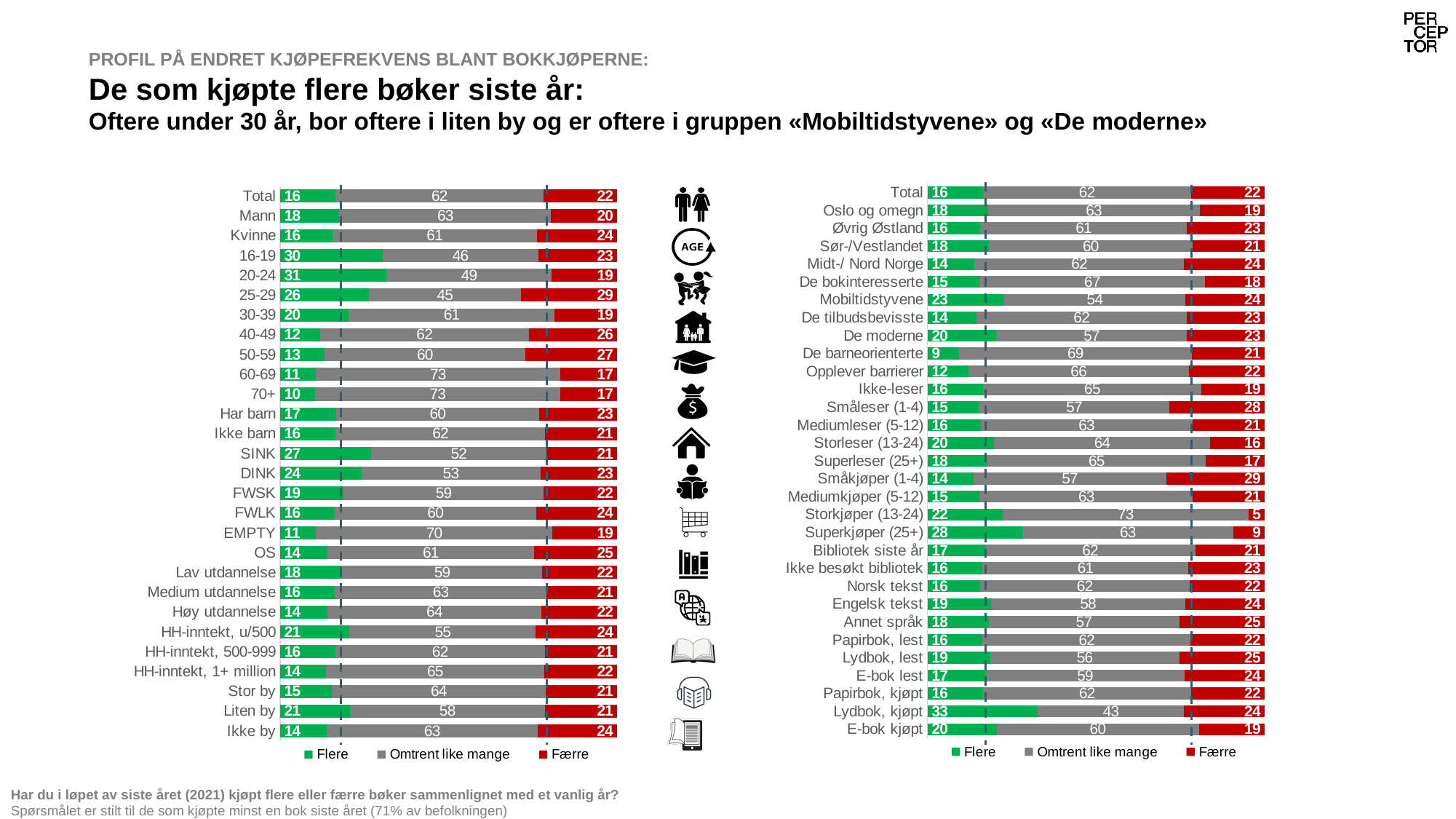
In the left chart, what is the 'Flere' value for the 20-24 age group? 31 In the left chart, which category has the lowest 'Flere' value? 70+ In the right chart, which category has the lowest 'Færre' value? Storkjøper (13-24) What kind of chart is the left chart on the slide? Stacked bar chart In the right chart, which category has the highest 'Flere' value? Lydbok, kjøpt In the right chart, what is the total of the stacked bar for Lydbok, kjøpt? 100 How many series does the legend of the left chart list? 3 In the left chart, what is the difference between the 'Færre' values for 25-29 and 20-24? 10 How many categories are plotted in the right chart? 31 Which colour represents 'Færre' in the charts? Red In the right chart, which has a larger 'Flere' value: De moderne or De barneorienterte? De moderne In the right chart, what is the 'Omtrent like mange' value for Mobiltidstyvene? 54